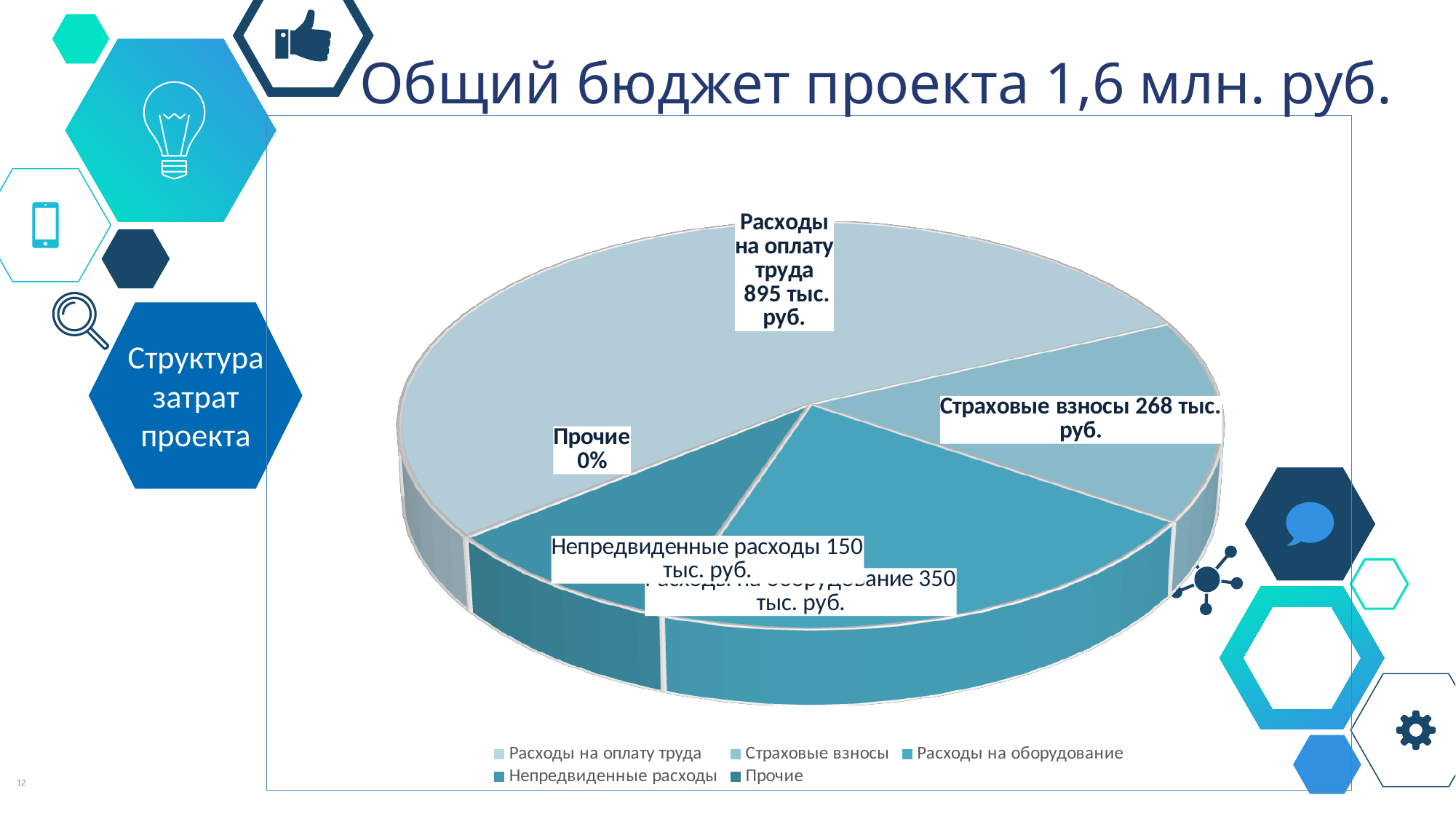
What is the difference between Расходы на оплату труда and Страховые взносы? 627 тыс. руб. Which category has the largest slice of the pie? Расходы на оплату труда Which is larger, Расходы на оборудование or Страховые взносы? Расходы на оборудование What is the value for Страховые взносы? 268 тыс. руб. What share of the pie is labelled for Прочие? 0% Which category with a non-zero value has the smallest slice? Непредвиденные расходы What is the value for Расходы на оборудование? 350 тыс. руб. How many entries does the legend list? 5 What kind of chart is shown on the slide? Pie chart What is the value for Расходы на оплату труда? 895 тыс. руб. What is the value for Непредвиденные расходы? 150 тыс. руб. What total project budget is stated in the slide title? 1,6 млн. руб.